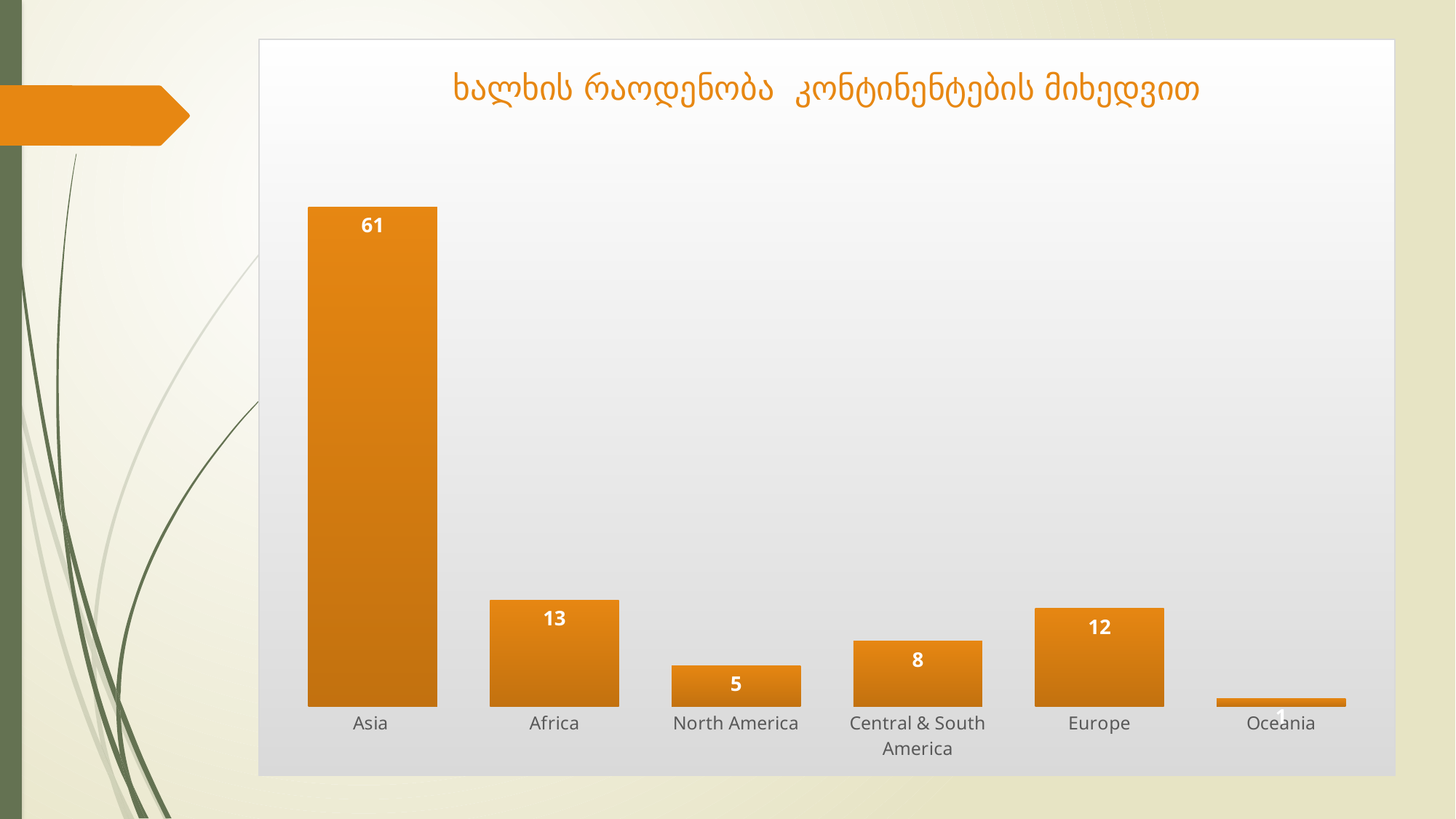
What is the difference between the values for Asia and Africa? 48 What is the value for North America? 5 How many categories are shown on the x axis? 6 What kind of chart is shown on the slide? Bar chart What is the difference between the values for Europe and North America? 7 Which category has the highest value? Asia What is the value for Asia? 61 What is the value for Europe? 12 What is the value for Africa? 13 Which category has the lowest value? Oceania Which is larger, the value for Africa or the value for Europe? Africa What is the value for Central & South America? 8